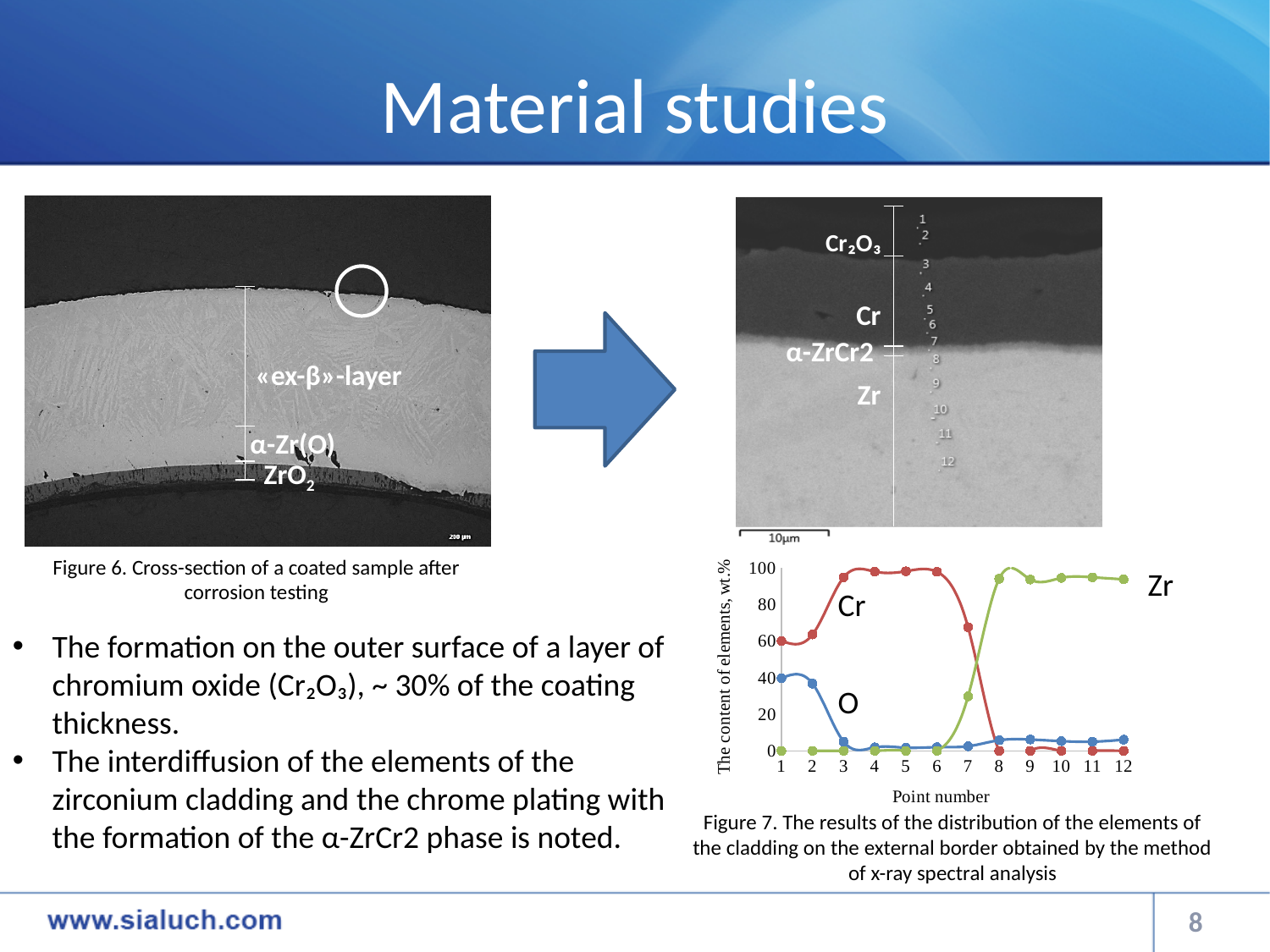
Is the O value at point number 1 greater or less than 20? greater Which elements are plotted in the Figure 7 chart? Cr, O, Zr At point number 9, which element has the higher content, Zr or O? Zr Is the Zr value at point number 3 greater or less than 20? less What is the y-axis title of the Figure 7 chart? The content of elements, wt.% Does the Zr content rise or fall as the point number increases from 6 to 9? rise Is the Cr value at point number 4 greater or less than 80? greater How many element series are plotted in the Figure 7 chart? 3 How many point numbers are plotted along the x axis of the Figure 7 chart? 12 What kind of chart is shown in Figure 7? line chart At point number 5, which element has the higher content, Cr or Zr? Cr